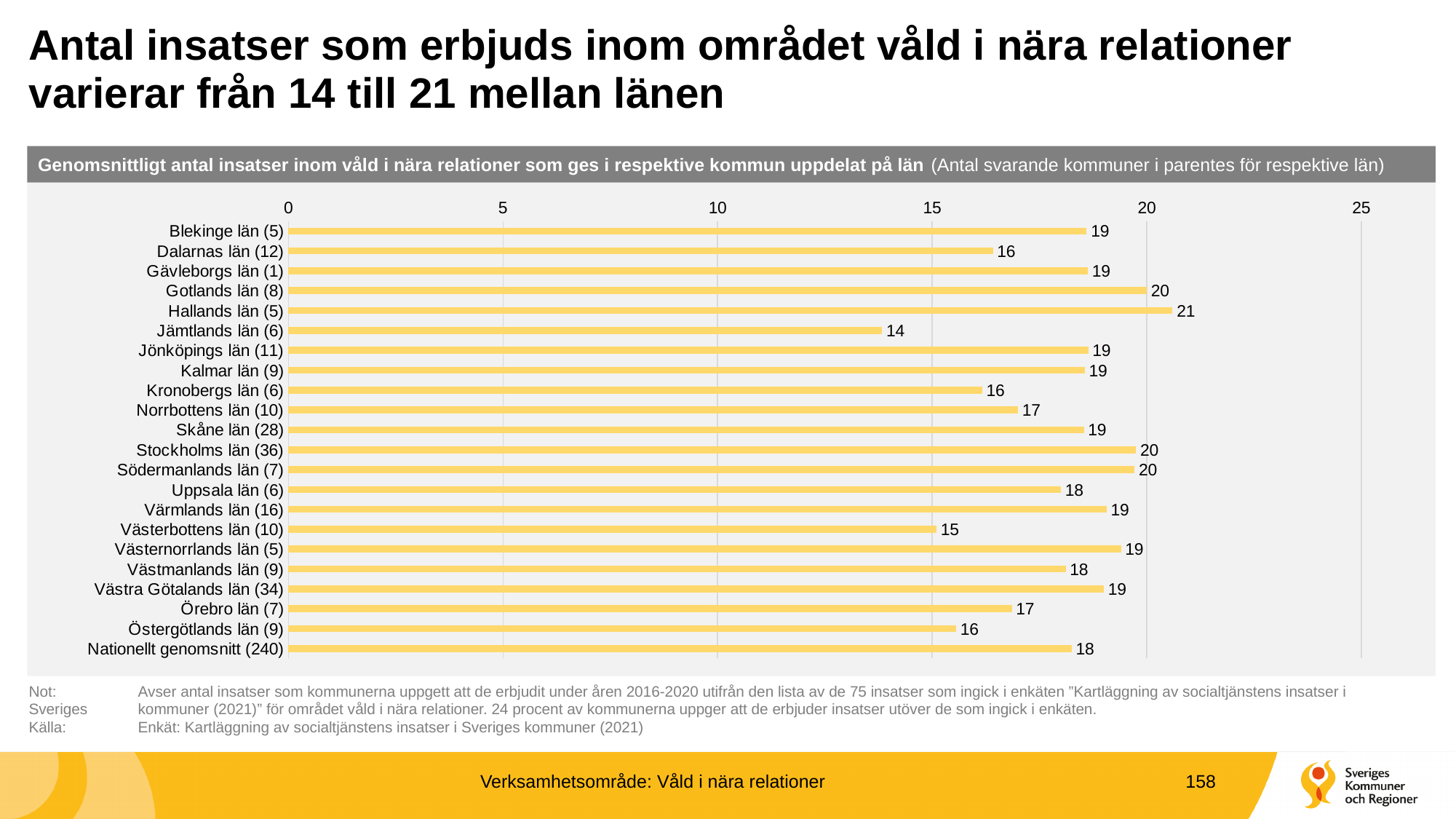
Which category has the highest value? Hallands län (5) What kind of chart is shown on the slide? Bar chart Which category has the lowest value? Jämtlands län (6) Is the value for Stockholms län (36) greater or less than 15? greater What is the value for Jämtlands län (6)? 14 What is the difference between the values for Hallands län (5) and Jämtlands län (6)? 7 Which is larger, the value for Gotlands län (8) or the value for Dalarnas län (12)? Gotlands län (8) What is the value for Nationellt genomsnitt (240)? 18 What is the value for Hallands län (5)? 21 What is the value for Västerbottens län (10)? 15 How many categories are shown in the chart? 22 What is the highest value shown on the chart's axis? 25